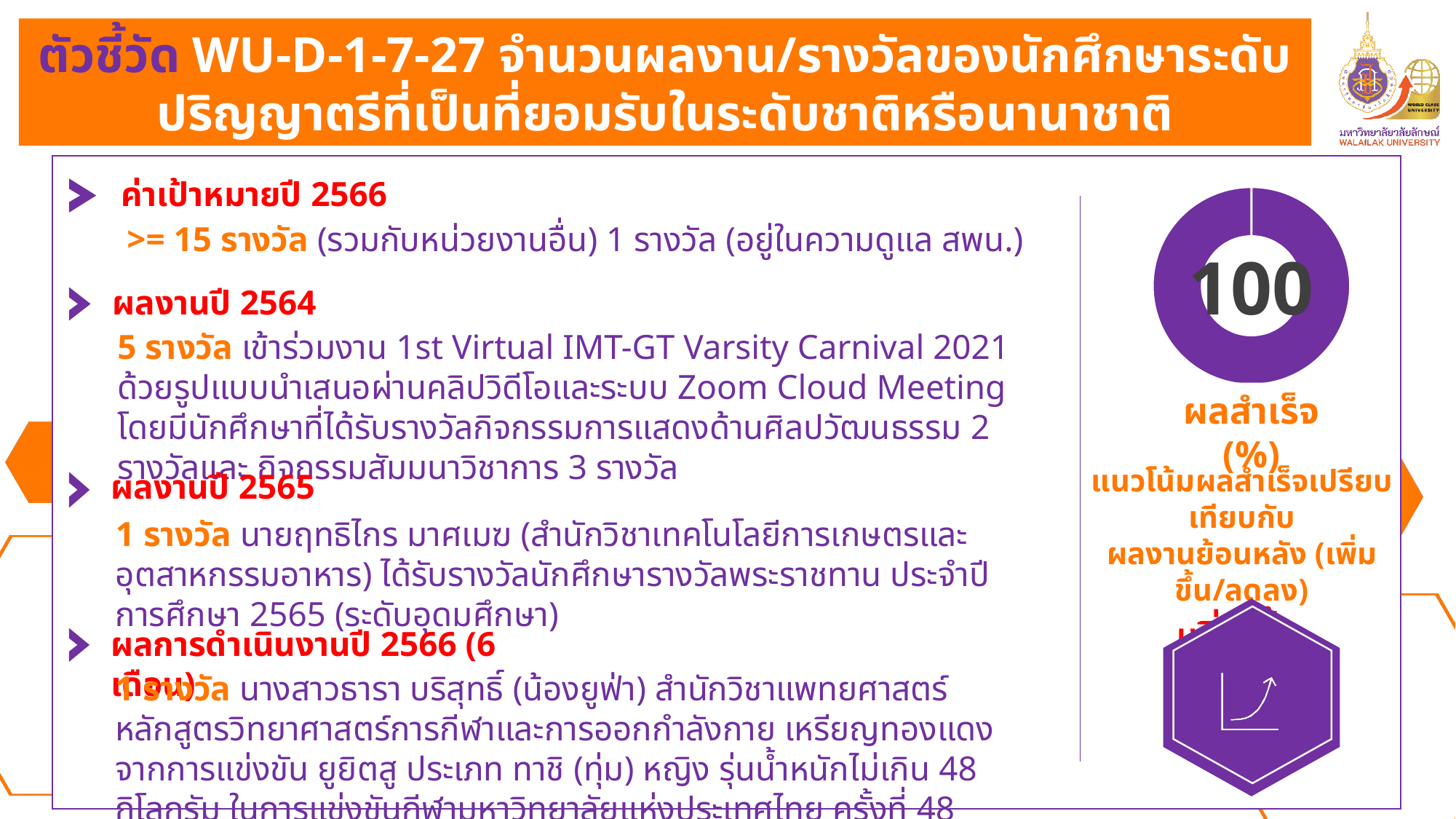
How many visible slices does the donut chart contain? 1 What colour is the filled ring of the donut chart? Purple What number is printed in the centre of the donut chart? 100 What is the label printed directly below the donut chart? ผลสำเร็จ (%) Is the value shown in the centre of the donut chart greater or less than 50? greater What share of the donut chart does the purple slice occupy? 100% What kind of chart is shown on the right side of the slide? Donut (pie) chart